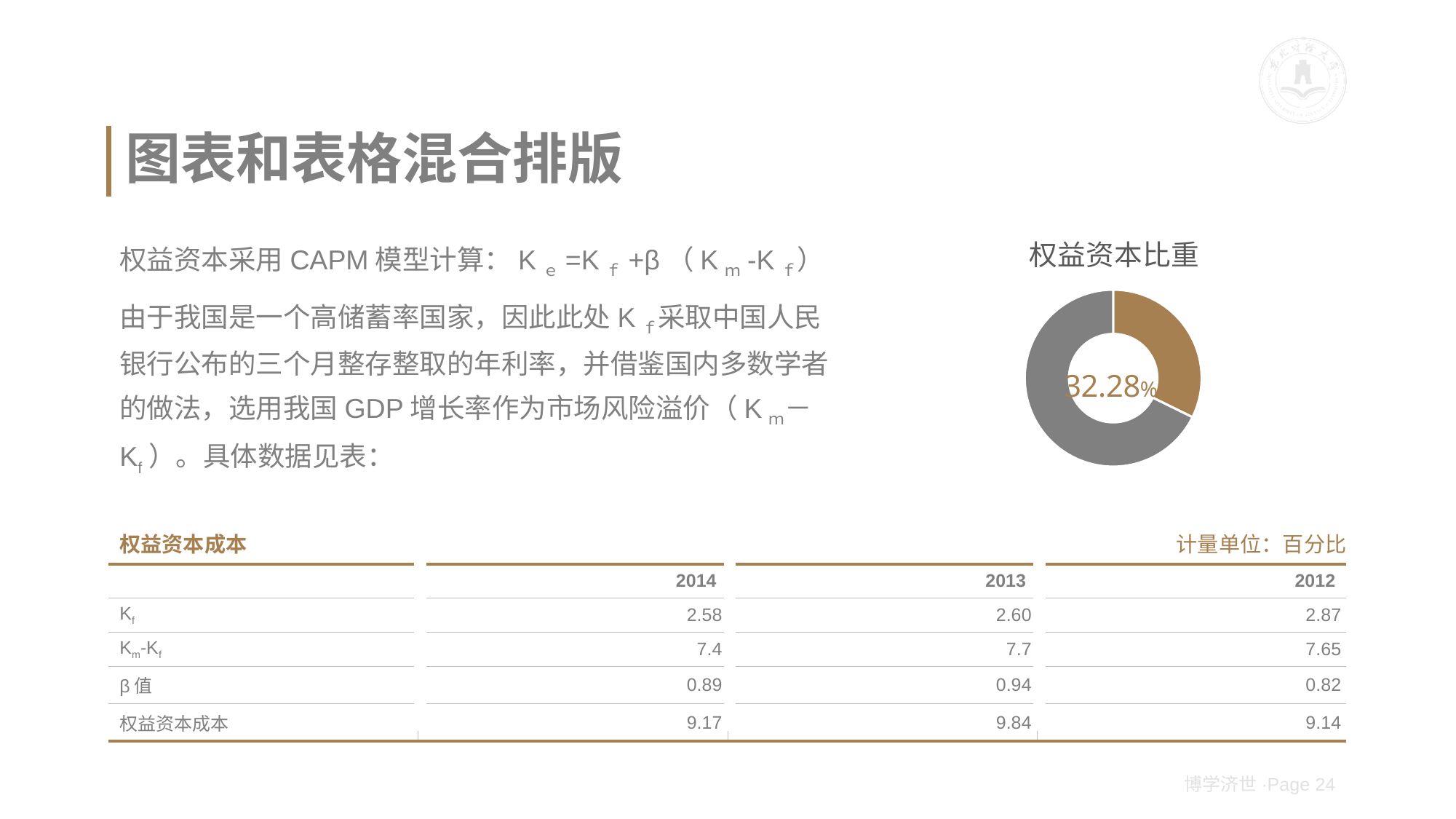
What value is printed in the centre of the 权益资本比重 chart? 32.28% What kind of chart is shown on the slide? Pie chart (donut) What two colours are used for the slices of the 权益资本比重 chart? Gold and grey In the 权益资本比重 chart, is the grey slice's share greater or less than 50%? greater What is the title of the chart on the slide? 权益资本比重 How many slices does the 权益资本比重 chart have? 2 In the 权益资本比重 chart, which slice is larger, the gold one or the grey one? The grey one In the 权益资本比重 chart, is the gold slice's share greater or less than 50%? less